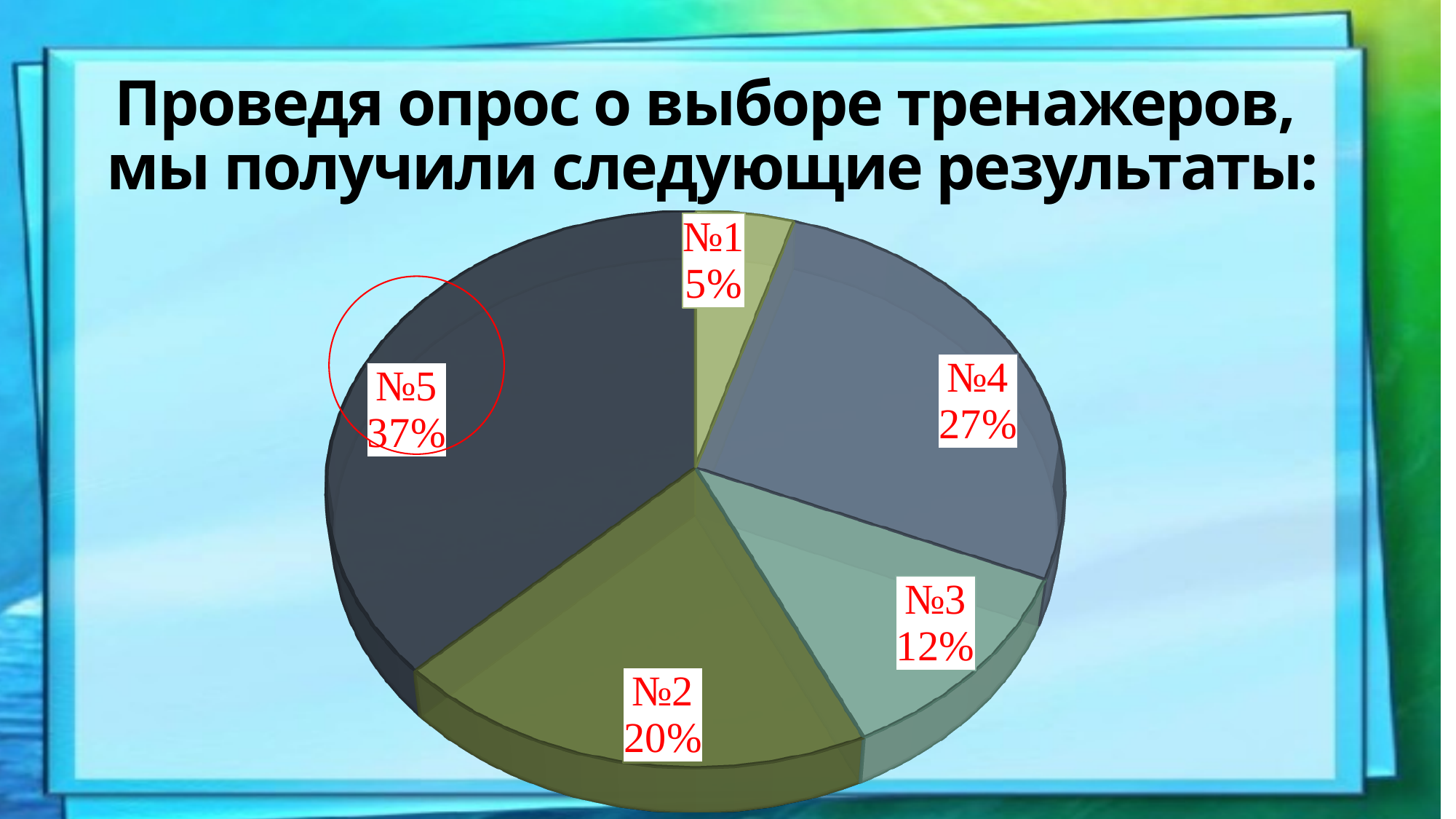
What kind of chart is shown on the slide? pie chart What share of the pie does №1 have? 5% What share of the pie does №2 have? 20% Which is larger, the share of №2 or the share of №3? №2 What is the difference between the shares of №5 and №4? 10% What share of the pie does №5 have? 37% How many slices does the pie chart have? 5 Which slice is the largest? №5 Which slice is circled in red on the slide? №5 Which slice is the smallest? №1